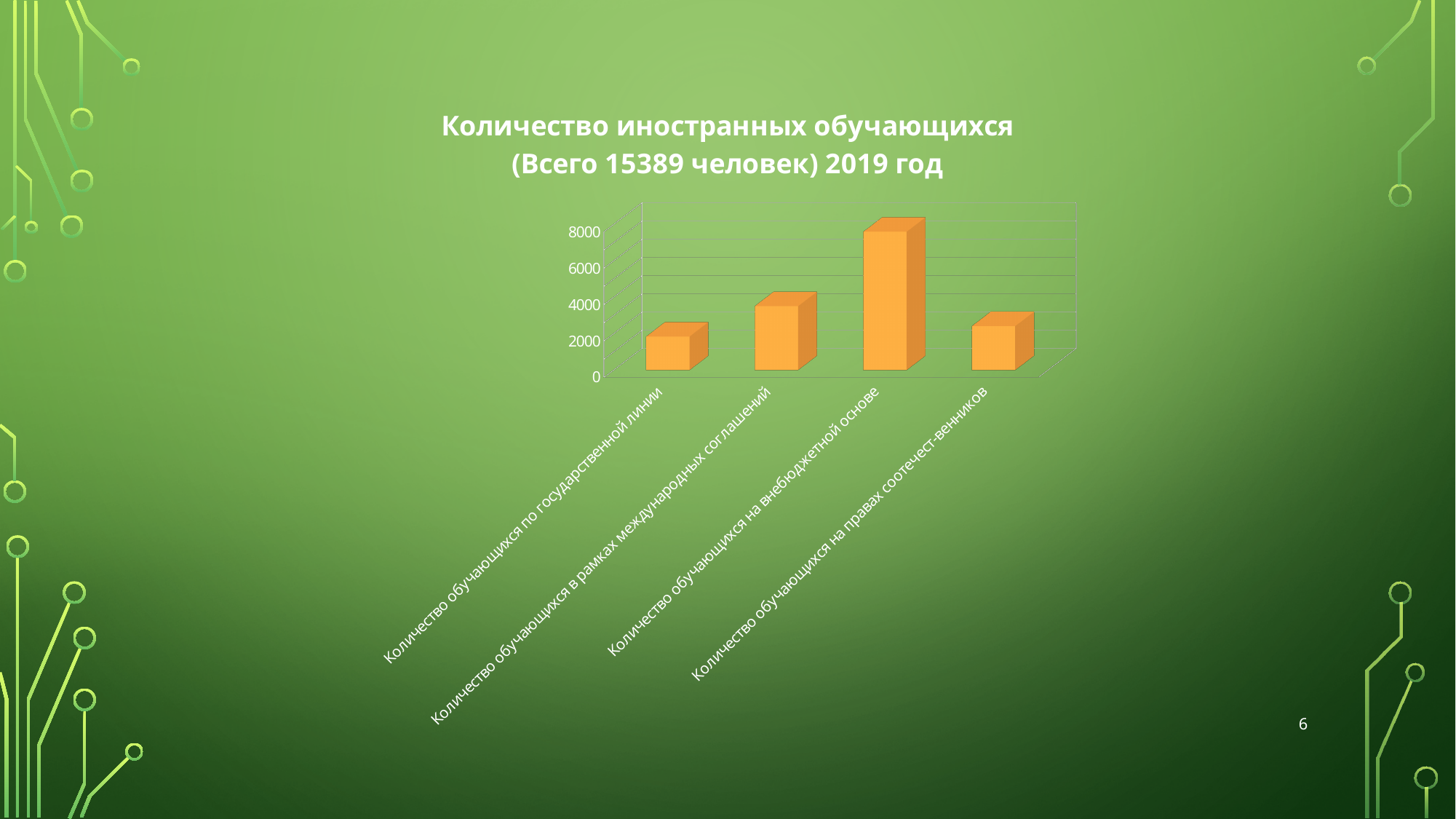
Which is larger: the value for 'Количество обучающихся на внебюджетной основе' or for 'Количество обучающихся по государственной линии'? Количество обучающихся на внебюджетной основе Which category has the highest value? Количество обучающихся на внебюджетной основе Which category has the lowest value? Количество обучающихся по государственной линии Is the value for 'Количество обучающихся на правах соотечественников' greater or less than 4000? less Is the value for 'Количество обучающихся в рамках международных соглашений' greater or less than 2000? greater How many categories are shown in the chart? 4 What is the title of the chart? Количество иностранных обучающихся (Всего 15389 человек) 2019 год According to the chart title, what is the total number of foreign students in 2019? 15389 Is the value for 'Количество обучающихся по государственной линии' greater or less than 4000? less What kind of chart is shown on the slide? bar chart Which is larger: the value for 'Количество обучающихся в рамках международных соглашений' or for 'Количество обучающихся на правах соотечественников'? Количество обучающихся в рамках международных соглашений